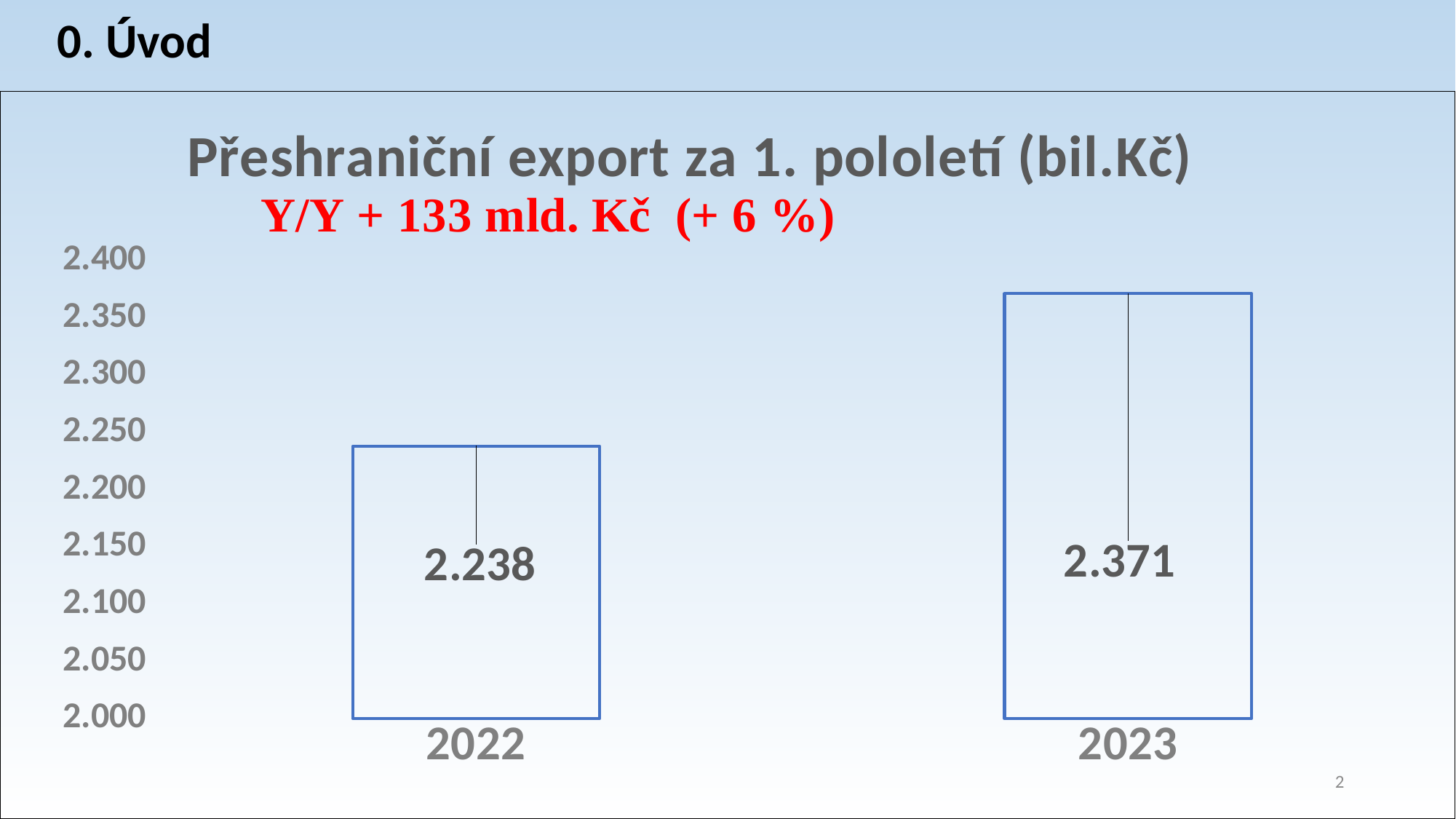
Is the value for 2022 greater or less than 2.250? less Do the values rise or fall from 2022 to 2023? rise What is the value for 2022? 2.238 Is the value for 2023 greater or less than 2.300? greater Is the value for 2022 larger or smaller than the value for 2023? smaller What kind of chart is shown on the slide? bar chart What is the value for 2023? 2.371 What is the difference between the values for 2023 and 2022? 0.133 What is the title of the chart? Přeshraniční export za 1. pololetí (bil.Kč) How many bars are shown in the chart? 2 Which year has the higher value? 2023 Which year has the lower value? 2022